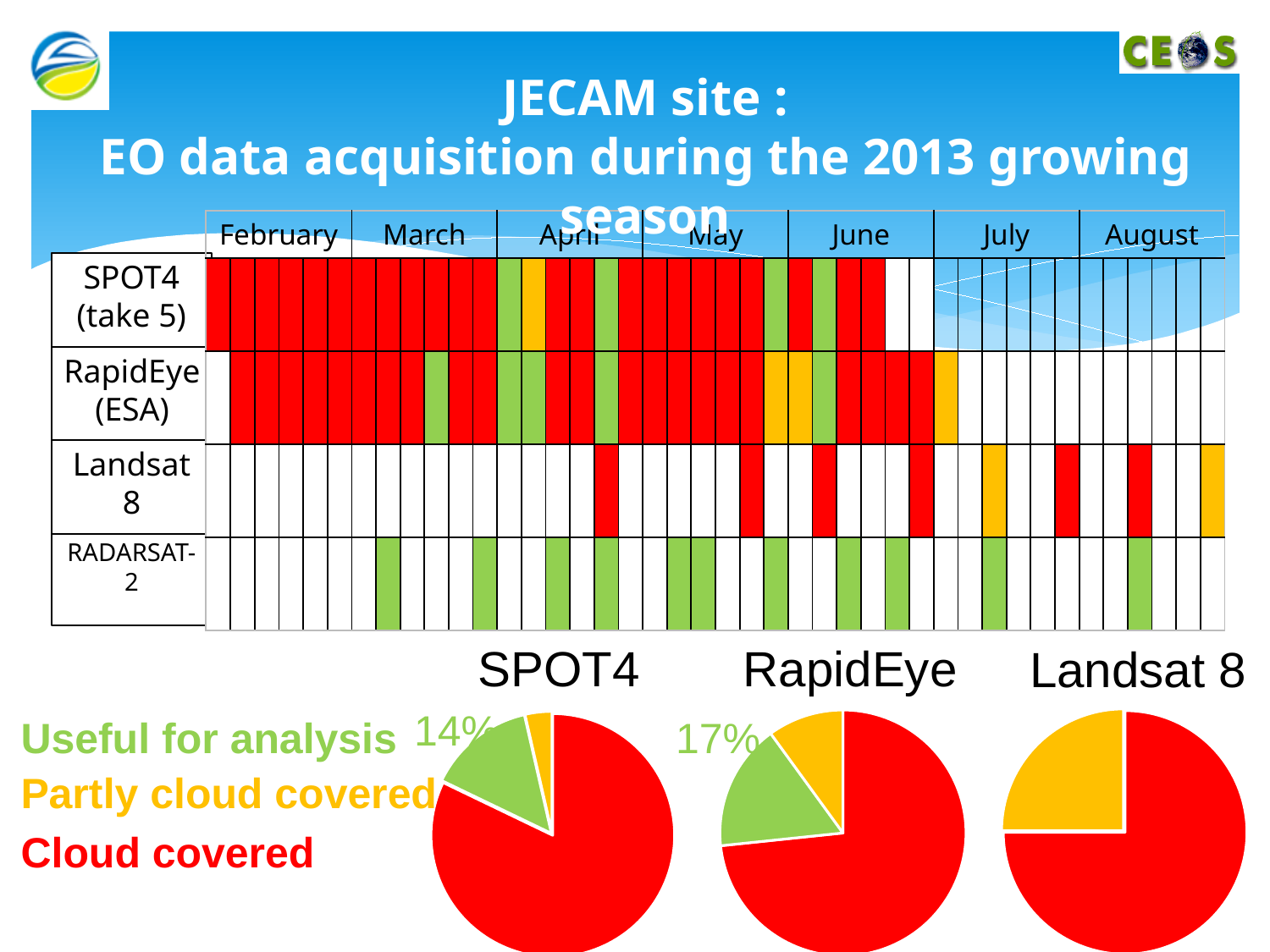
What kind of chart is used for SPOT4, RapidEye and Landsat 8 at the bottom of the slide? Pie chart How many categories does the legend for the pie charts list? 3 Which has a larger share useful for analysis, the SPOT4 pie chart or the RapidEye pie chart? RapidEye In the RapidEye pie chart, what share of the data is useful for analysis? 17% In the RapidEye pie chart, which category has the largest slice? Cloud covered In the SPOT4 pie chart, which category has the largest slice? Cloud covered What colour represents 'Cloud covered' in the pie charts? Red In the Landsat 8 pie chart, which category has the largest slice? Cloud covered In the SPOT4 pie chart, which category has the smallest slice? Partly cloud covered How many pie charts are shown on the slide? 3 In the SPOT4 pie chart, what share of the data is useful for analysis? 14% What is the difference between the useful-for-analysis share in the RapidEye pie chart and in the SPOT4 pie chart? 3%